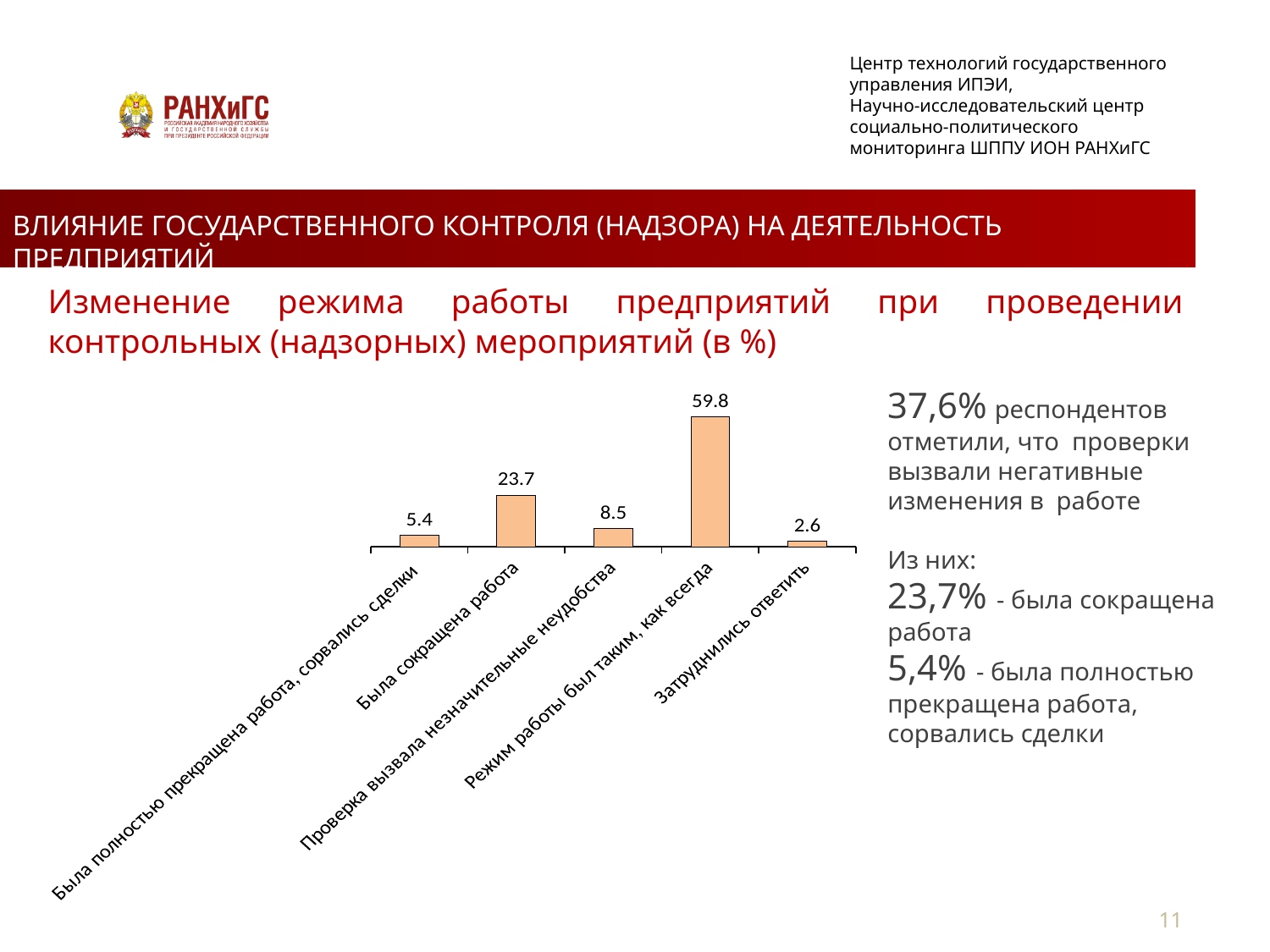
What value is shown for the category "Затруднились ответить"? 2.6 Which category has the highest value? Режим работы был таким, как всегда What colour are the bars in the chart? Light orange Which category has the lowest value? Затруднились ответить What value is shown for the category "Проверка вызвала незначительные неудобства"? 8.5 What value is shown for the category "Режим работы был таким, как всегда"? 59.8 How many categories are shown in the chart? 5 What value is shown for the category "Была сокращена работа"? 23.7 Which is larger: the value for "Проверка вызвала незначительные неудобства" or the value for "Была полностью прекращена работа, сорвались сделки"? Проверка вызвала незначительные неудобства What is the difference between the values for "Была сокращена работа" and "Была полностью прекращена работа, сорвались сделки"? 18.3 What is the difference between the values for "Режим работы был таким, как всегда" and "Была сокращена работа"? 36.1 What kind of chart is shown on the slide? Bar chart